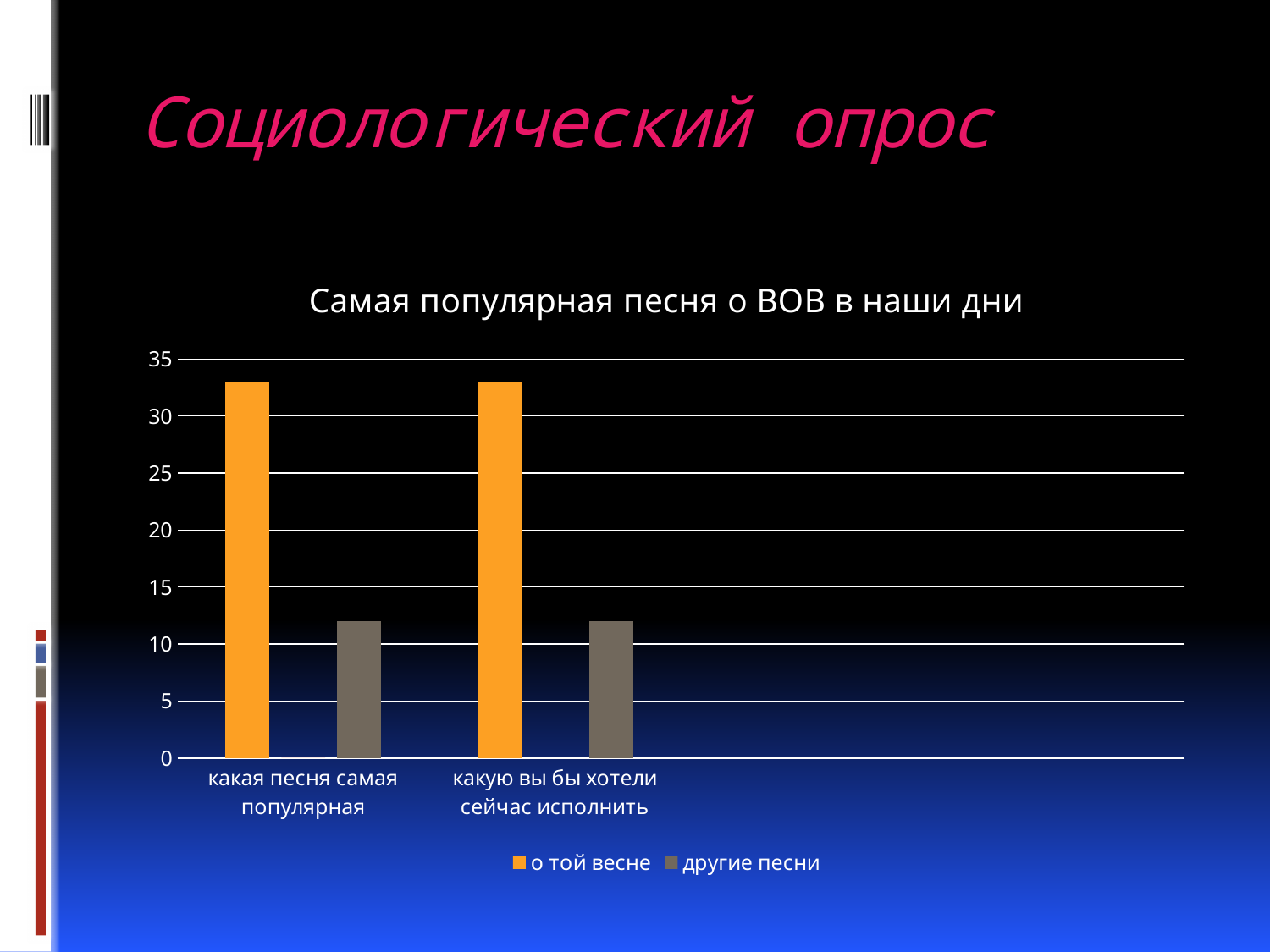
Which series has the highest bar in the chart? о той весне In the category 'какая песня самая популярная', which series has the larger value, 'о той весне' or 'другие песни'? о той весне Which series is shown in orange? о той весне How many series does the legend list? 2 What type of chart is shown on the slide? bar chart Is the value for 'о той весне' in the category 'какую вы бы хотели сейчас исполнить' greater or less than 35? less In the category 'какую вы бы хотели сейчас исполнить', which series has the smaller value? другие песни Is the value for 'другие песни' in the category 'какая песня самая популярная' greater or less than 15? less Is the value for 'о той весне' in the category 'какая песня самая популярная' greater or less than 30? greater How many categories are shown on the x axis? 2 What is the title of the chart? Самая популярная песня о ВОВ в наши дни